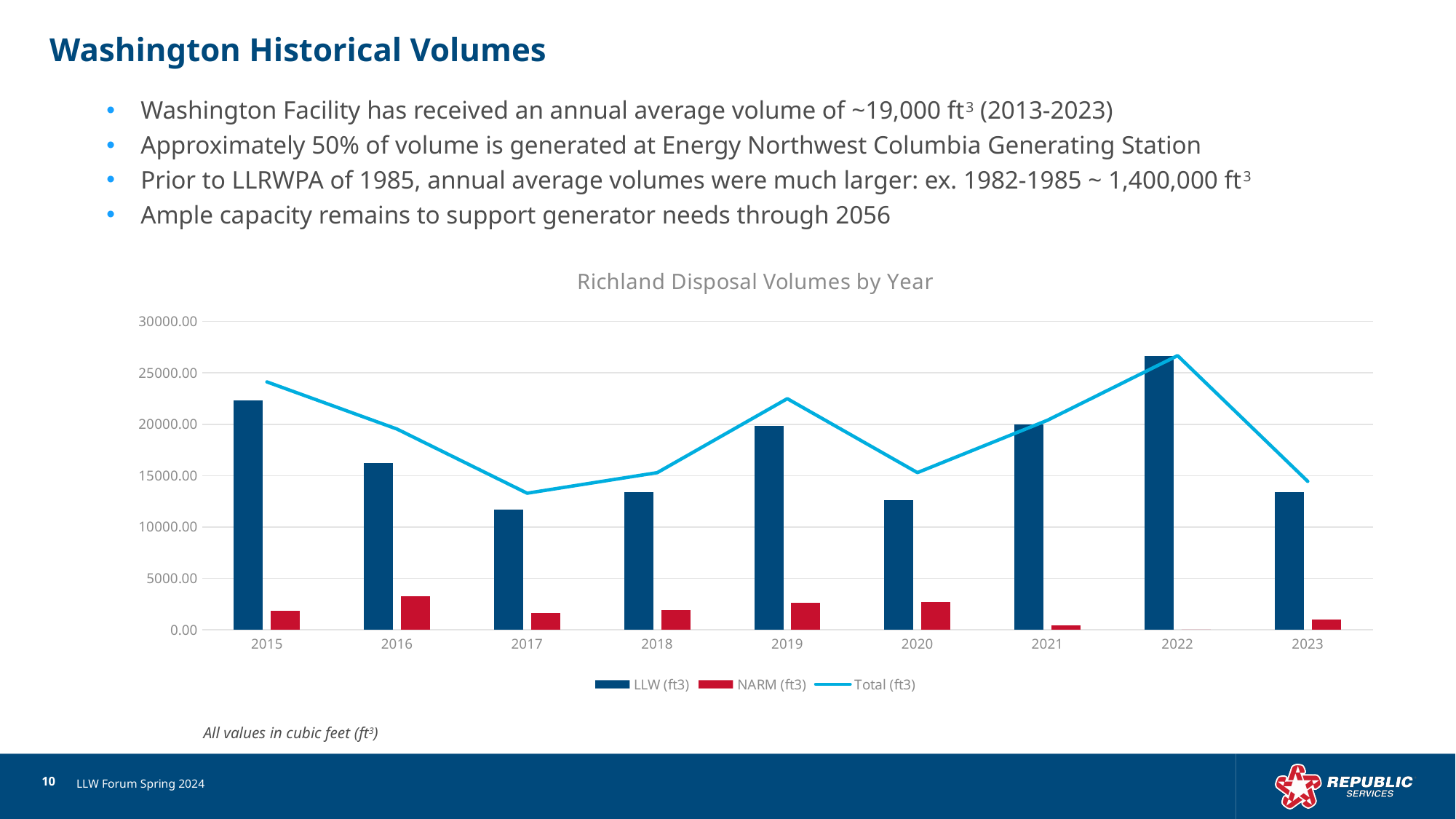
How many series does the chart legend list? 3 What is the title of the chart? Richland Disposal Volumes by Year What kind of chart is shown on the slide? Combined bar and line chart Does the Total (ft3) line rise or fall from 2015 to 2017? fall Which year has the larger LLW (ft3) value, 2019 or 2020? 2019 Is the LLW (ft3) value for 2015 greater or less than 20000? greater In which year is the NARM (ft3) bar the lowest? 2022 How many years are shown on the x axis of the chart? 9 In which year is the NARM (ft3) bar the highest? 2016 Is the LLW (ft3) value for 2017 greater or less than 15000? less In which year is the LLW (ft3) bar the highest? 2022 Is the Total (ft3) value for 2019 greater or less than 20000? greater